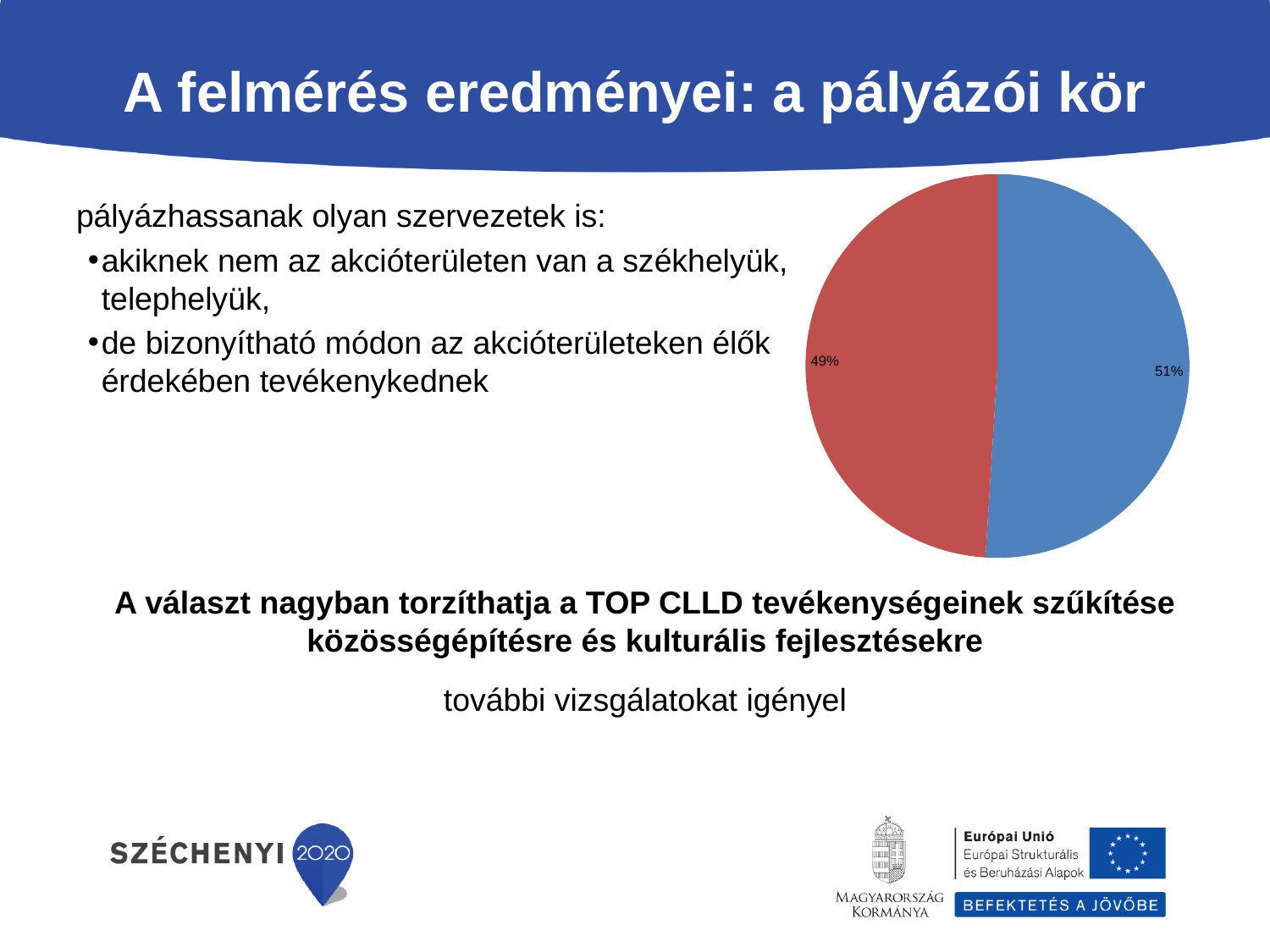
What share of the pie does the red slice represent? 49% Which slice of the pie chart is larger, the blue one or the red one? the blue one Is the share of the red slice greater or less than 50%? less Which slice of the pie chart is the smallest? the red slice (49%) What is the difference in percentage points between the blue slice and the red slice? 2 percentage points Does the pie chart have a legend? No What kind of chart is shown on the slide? pie chart What two colours are used for the slices of the pie chart? blue and red Which slice of the pie chart is the largest? the blue slice (51%) How many slices does the pie chart have? 2 Is the share of the blue slice greater or less than 50%? greater What share of the pie does the blue slice represent? 51%